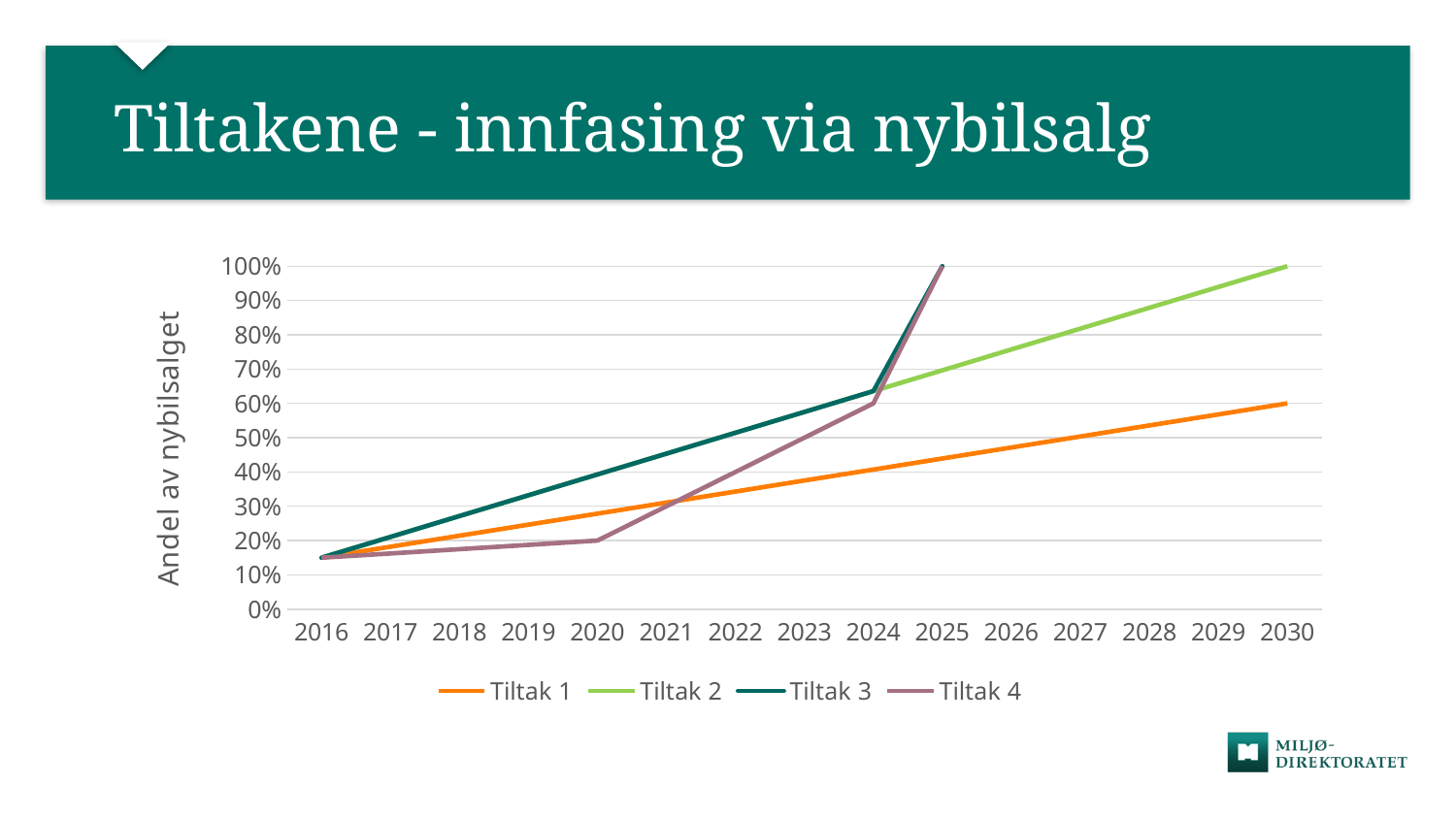
Is the value for Tiltak 3 in 2020 greater or less than 30%? greater How many series does the legend list? 4 What is the title of the y axis? Andel av nybilsalget What is the value for Tiltak 4 in 2020? 20% Is the value for Tiltak 1 in 2024 greater or less than 50%? less How many years are shown on the x axis? 15 What is the value for Tiltak 1 in 2030? 60% What is the value for Tiltak 3 in 2025? 100% What is the difference between Tiltak 2 and Tiltak 1 in 2030? 40 percentage points In 2030, which is higher: Tiltak 1 or Tiltak 2? Tiltak 2 What kind of chart is shown on the slide? line chart What is the value for Tiltak 2 in 2030? 100%